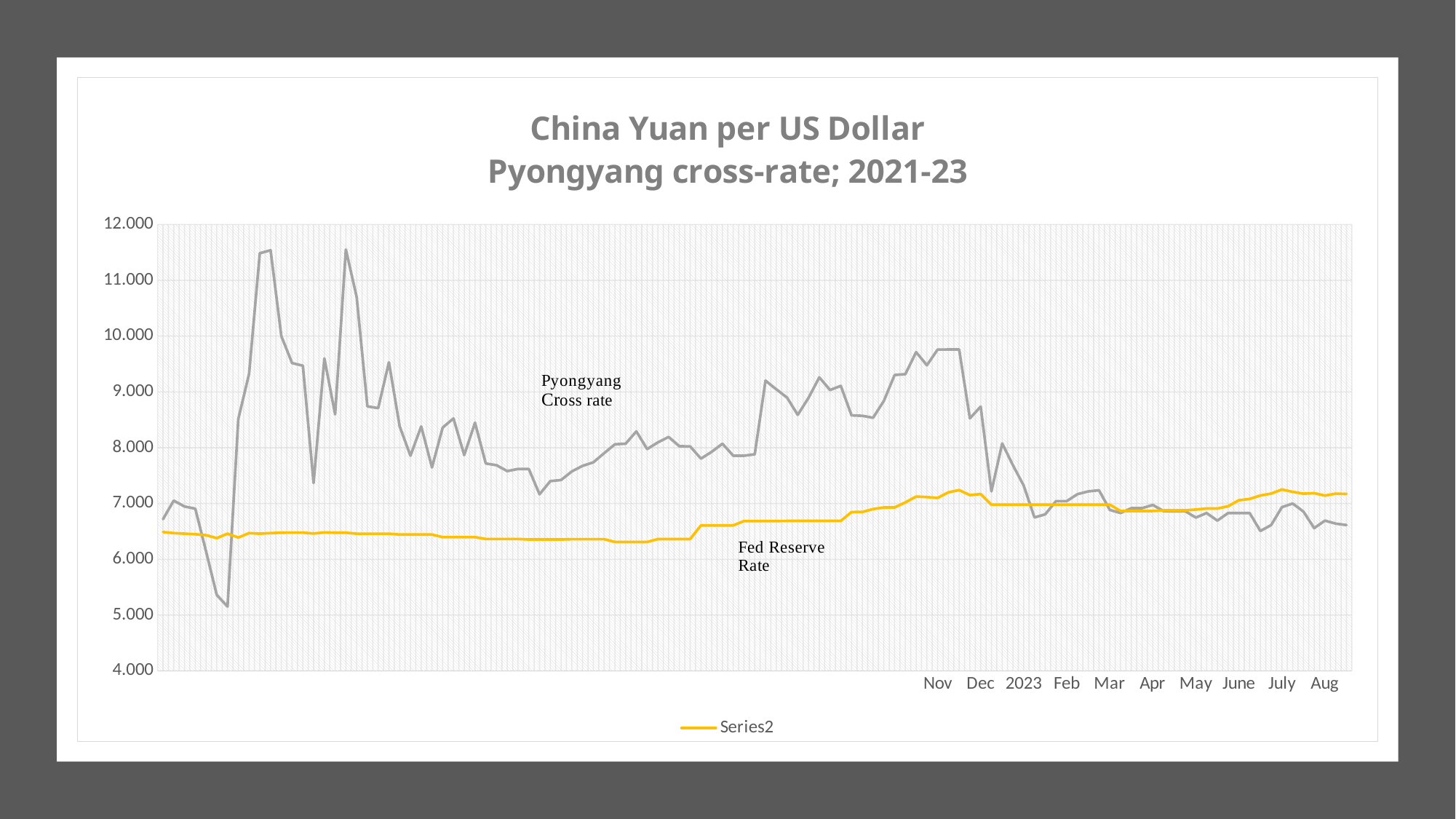
What kind of chart is shown on the slide? line chart Is the Fed Reserve Rate value at Aug greater or less than 7.000? greater What is the title of the chart? China Yuan per US Dollar Pyongyang cross-rate; 2021-23 Which of the two plotted lines reaches the highest value on the chart, the Pyongyang Cross rate or the Fed Reserve Rate? Pyongyang Cross rate Is the highest value of the Fed Reserve Rate line greater or less than 8.000? less How many entries does the legend list? 1 At Aug, which line is higher, the Pyongyang Cross rate or the Fed Reserve Rate? Fed Reserve Rate Is the peak value of the Pyongyang Cross rate line greater or less than 11.000? greater Does the Fed Reserve Rate line generally rise or fall from the left of the chart to the right? rise At Nov, which line is higher, the Pyongyang Cross rate or the Fed Reserve Rate? Pyongyang Cross rate What entry does the chart's legend list? Series2